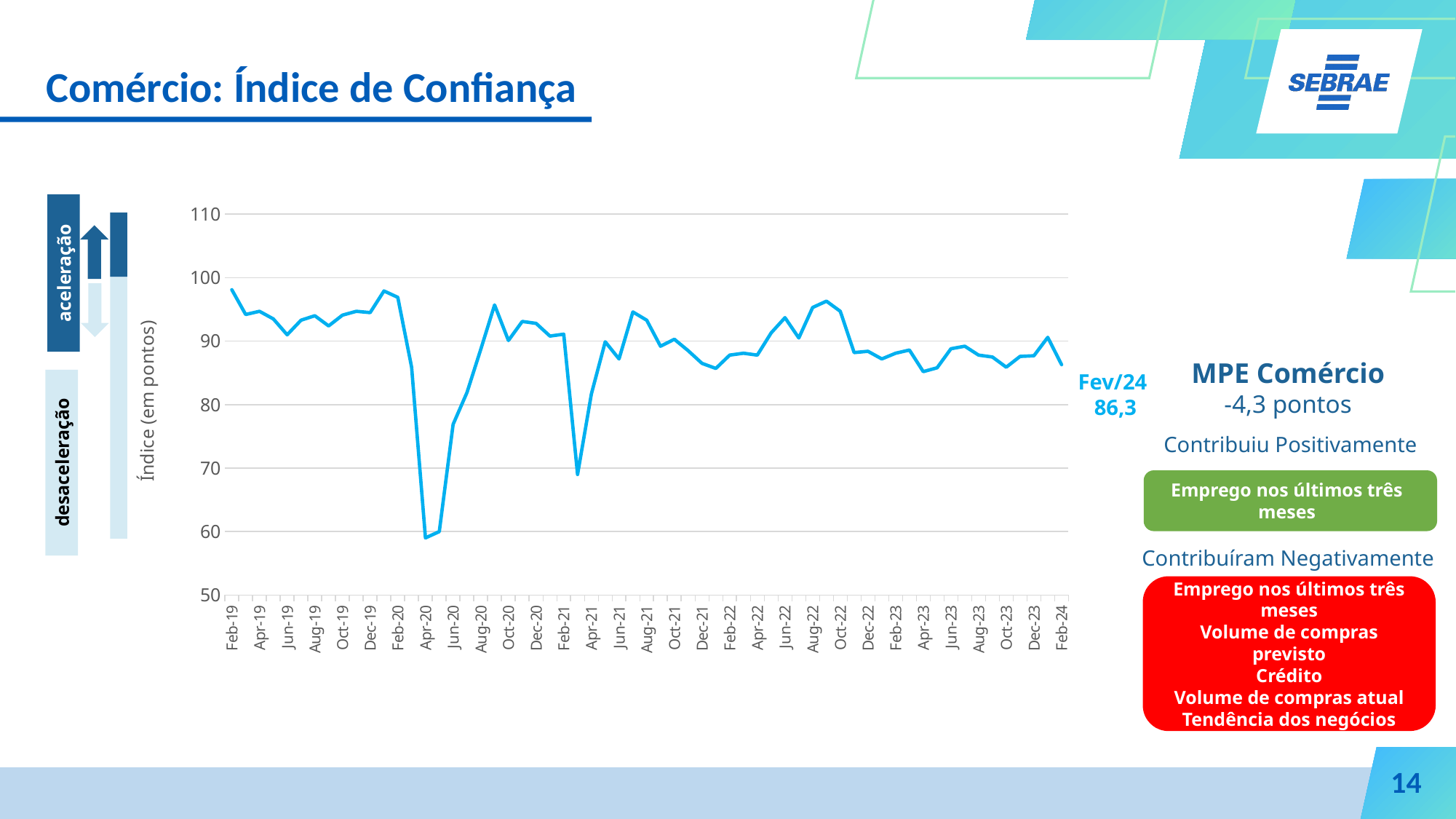
What kind of chart is shown on the slide? line chart Is the value for Feb-19 greater or less than 90? greater What is the label of the vertical axis? Índice (em pontos) In which month does the index reach its lowest point? Apr-20 Which is larger, the index value for Feb-19 or for Feb-24? Feb-19 Does the index rise or fall between Dec-23 and Feb-24? fall How many data series are plotted on the chart? 1 What is the title of the slide containing the chart? Comércio: Índice de Confiança Is the value for Feb-21 greater or less than 80? greater What is the value of the index for Feb-24 (Fev/24)? 86,3 Is the value for Apr-20 greater or less than 70? less